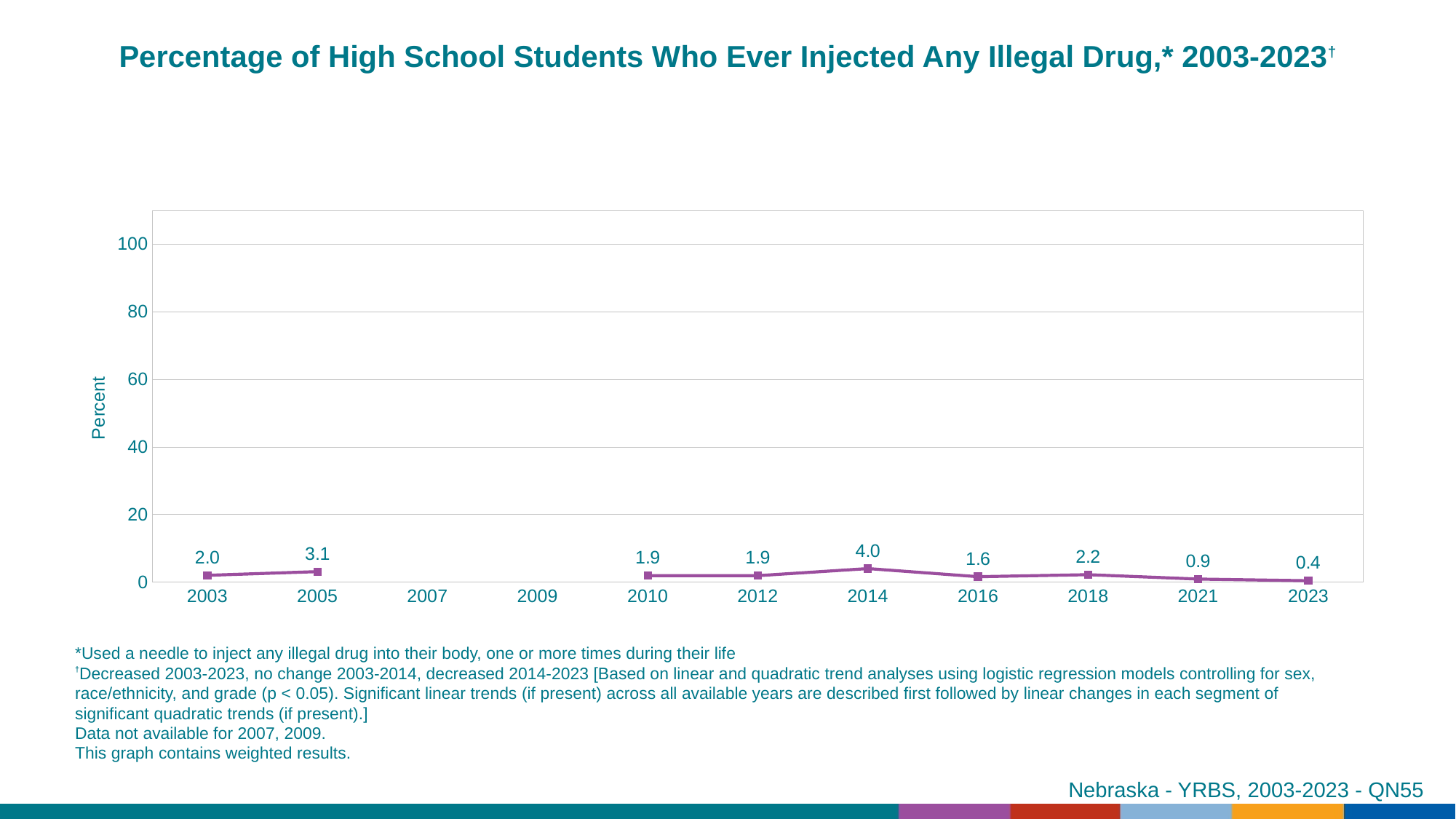
What is the value for 2005? 3.1 Do the values rise or fall from 2014 to 2023? fall Which year has the highest value? 2014 What is the value for 2023? 0.4 What is the difference between the values for 2014 and 2023? 3.6 Which year has the lowest value? 2023 How many years have data points plotted on the chart? 10 What kind of chart is this? line chart What is the value for 2014? 4.0 Is the value for 2014 greater or less than 20? less Which is larger, the value for 2005 or the value for 2018? 2005 What is the label on the y axis? Percent